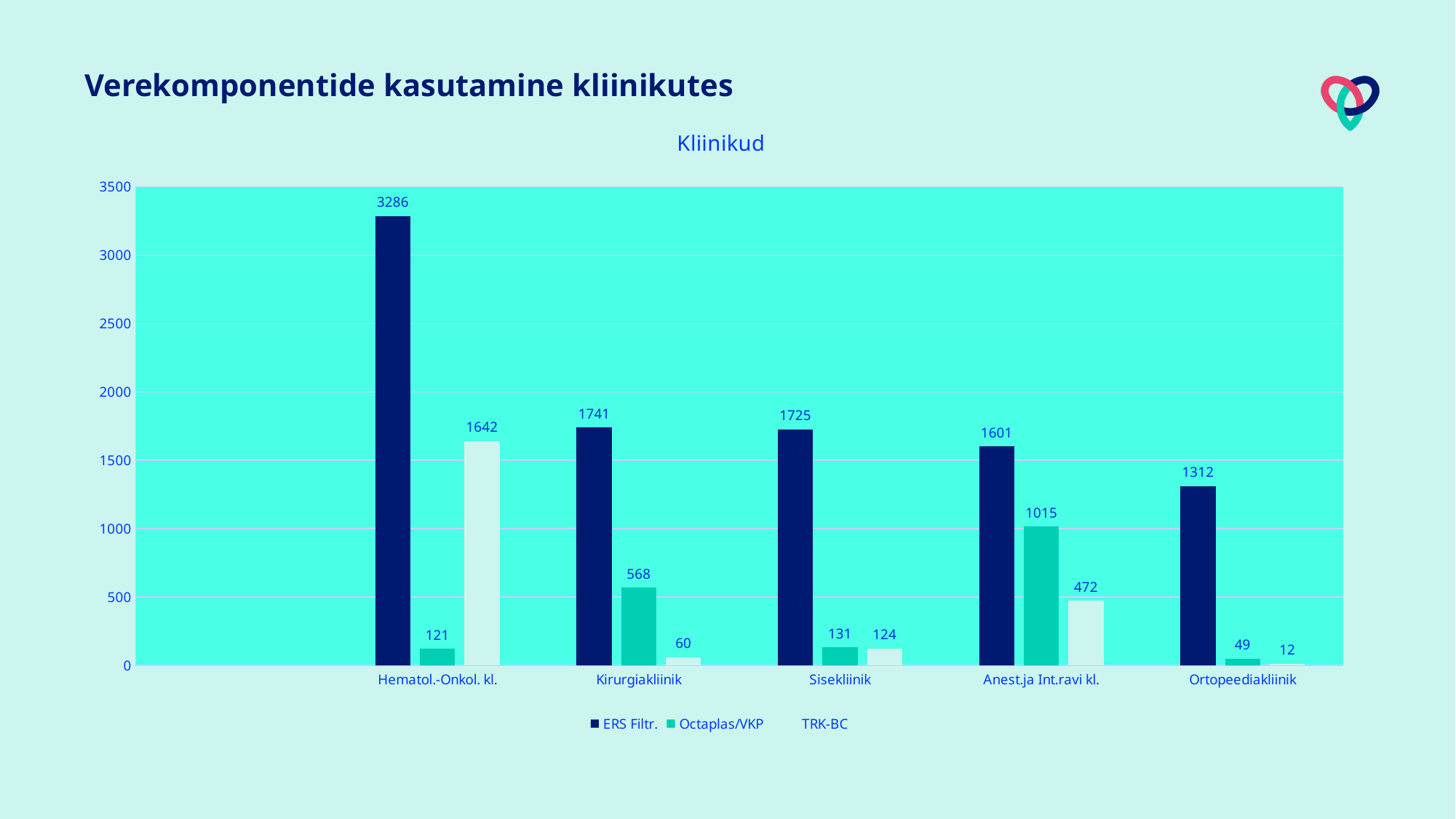
How many series does the legend list? 3 What kind of chart is shown on the slide? bar chart What is the TRK-BC value for Kirurgiakliinik? 60 What is the title of the chart? Kliinikud What is the ERS Filtr. value for Hematol.-Onkol. kl.? 3286 Is the TRK-BC value for Hematol.-Onkol. kl. greater or less than 1500? greater How many clinics are shown on the x axis? 5 Which clinic has the highest ERS Filtr. value? Hematol.-Onkol. kl. Which clinic has the lowest TRK-BC value? Ortopeediakliinik What is the Octaplas/VKP value for Anest.ja Int.ravi kl.? 1015 Which is larger for Sisekliinik: the Octaplas/VKP value or the TRK-BC value? Octaplas/VKP What is the difference between the ERS Filtr. values for Kirurgiakliinik and Sisekliinik? 16